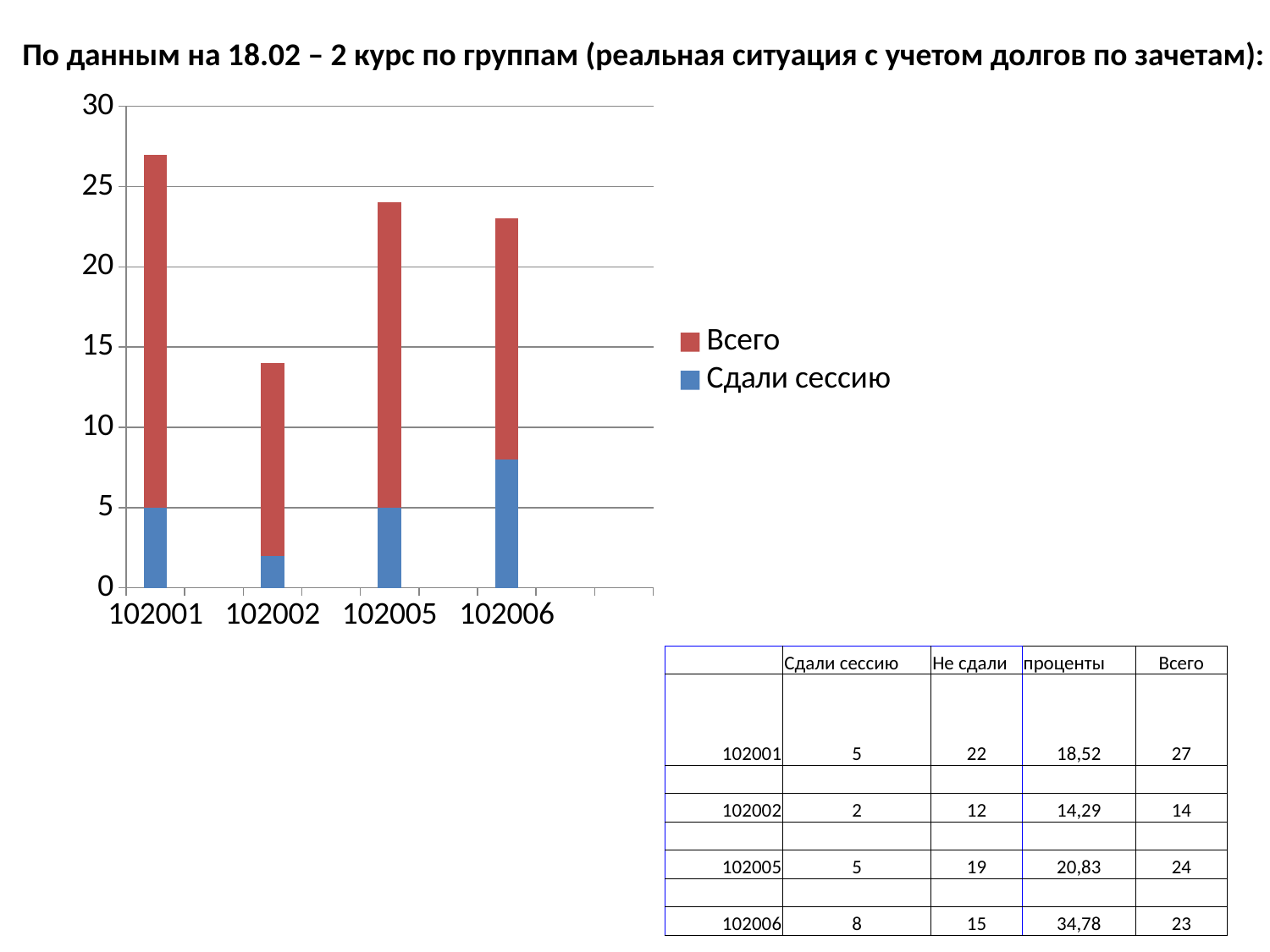
Which colour represents the "Сдали сессию" series in the chart? blue How many series does the chart legend list? 2 What is the difference between the "Всего" values for groups 102001 and 102002? 13 Which group has the shortest bar (lowest "Всего")? 102002 How many groups (categories) are plotted on the x axis of the chart? 4 Which group has the highest value of "Сдали сессию"? 102006 What kind of chart is shown on the slide? bar chart Is the "Всего" value for group 102002 greater or less than 15? less What is the value of "Сдали сессию" for group 102002? 2 What is the value of "Сдали сессию" for group 102006? 8 What is the value of "Всего" for group 102001? 27 Which group has the tallest bar (highest "Всего")? 102001